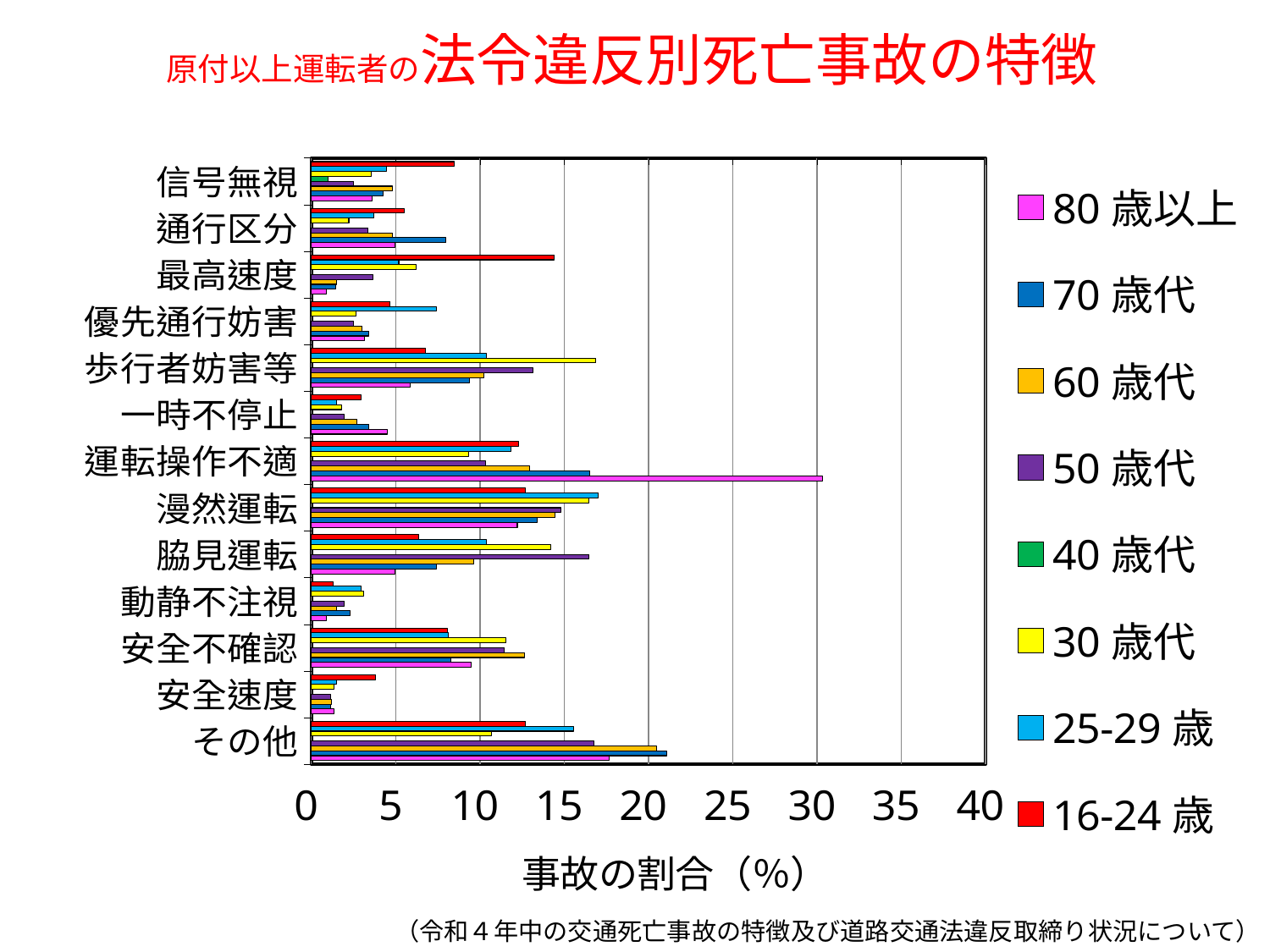
How many violation categories are listed on the vertical axis of the chart? 13 Which age group has the longest bar for 運転操作不適? 80 歳以上 What is the title of the horizontal axis of the chart? 事故の割合（%） Is the value for 80 歳以上 in 運転操作不適 greater or less than 25? greater For 歩行者妨害等, which is larger: the value for 30 歳代 or the value for 16-24 歳? 30 歳代 For 最高速度, which is larger: the value for 16-24 歳 or the value for 80 歳以上? 16-24 歳 What kind of chart is shown on the slide? bar chart Is the value for 16-24 歳 in 最高速度 greater or less than 10? greater How many age-group series does the legend list? 8 Which violation category contains the single longest bar in the chart? 運転操作不適 Is the value for 70 歳代 in その他 greater or less than 15? greater